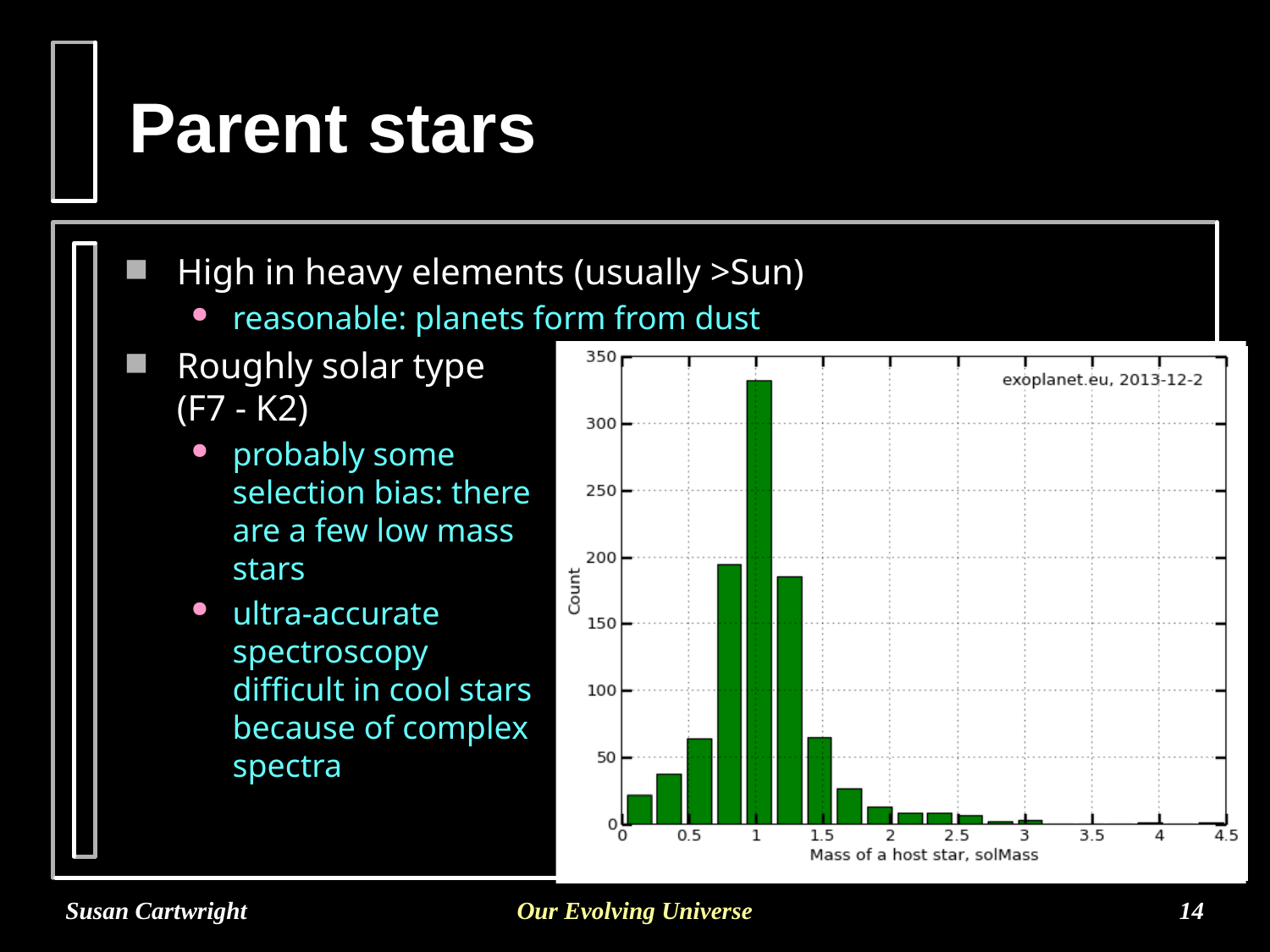
Around which host star mass (in solMass) does the tallest bar of the histogram occur? 1 Which bar is taller: the one just below 1 solMass (around 0.8) or the one just above 1 solMass (around 1.2)? the one around 0.8 solMass What kind of chart is shown on the slide? bar chart (histogram) Is the count for the bar just above 1 solMass (around 1.2 solMass) greater or less than 200? less Is the count for the tallest bar (near 1 solMass) greater or less than 300? greater Do the counts rise or fall as host star mass increases from 1 solMass to 3 solMass? fall Is the count for the bar just below 1 solMass (around 0.8 solMass) greater or less than 150? greater What is the highest value shown on the y axis of the chart? 350 What is the label of the y axis of the chart? Count Do the counts rise or fall as host star mass increases from 0 solMass to 1 solMass? rise What is the label of the x axis of the chart? Mass of a host star, solMass